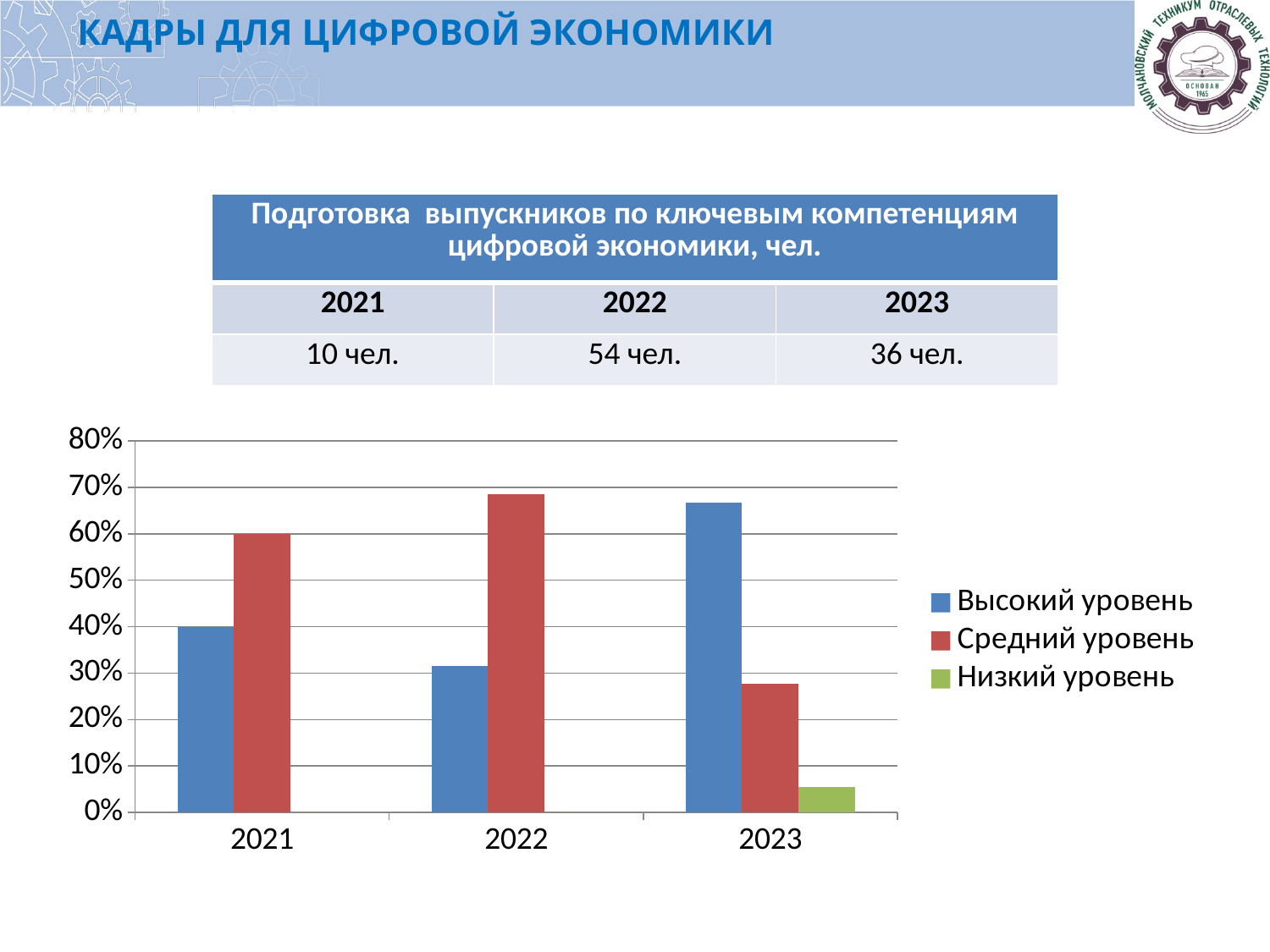
Is the value for Средний уровень in 2022 greater or less than 60%? greater Which is larger in 2021, Высокий уровень or Средний уровень? Средний уровень How many series does the legend list? 3 How many years are shown on the x axis of the chart? 3 Is the value for Низкий уровень in 2023 greater or less than 10%? less Which is larger in 2023, Высокий уровень or Средний уровень? Высокий уровень Which colour represents Низкий уровень in the legend? green What kind of chart is shown on the slide? bar chart In which year is the Высокий уровень bar the lowest? 2022 In which year is the Средний уровень bar the highest? 2022 Is the value for Высокий уровень in 2022 greater or less than 40%? less